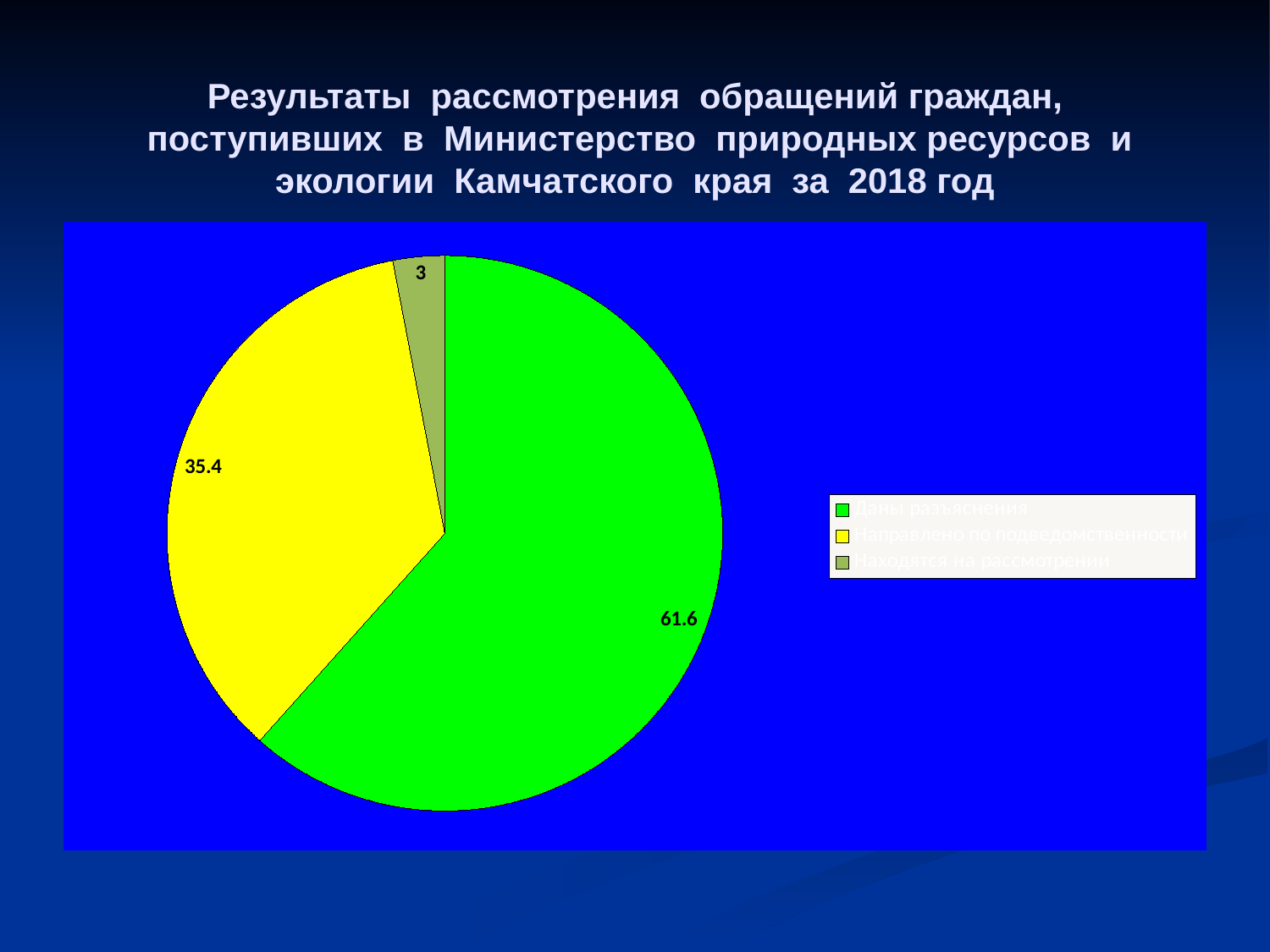
Which category has the smallest slice of the pie? Находятся на рассмотрении How many entries does the legend of the pie chart list? 3 How many slices does the pie chart have? 3 What kind of chart is shown on the slide? pie chart Which category has the largest slice of the pie? Даны разъяснения What value is shown on the green slice (Даны разъяснения)? 61.6 What value is shown on the smallest, olive-coloured slice (Находятся на рассмотрении)? 3 What value is shown on the yellow slice (Направлено по подведомственности)? 35.4 What is the difference between the values of the green slice and the yellow slice? 26.2 What colour is the slice for Направлено по подведомственности? yellow What share of the pie does the green slice (Даны разъяснения) represent? 61.6 Which is larger: the yellow slice or the olive slice? the yellow slice